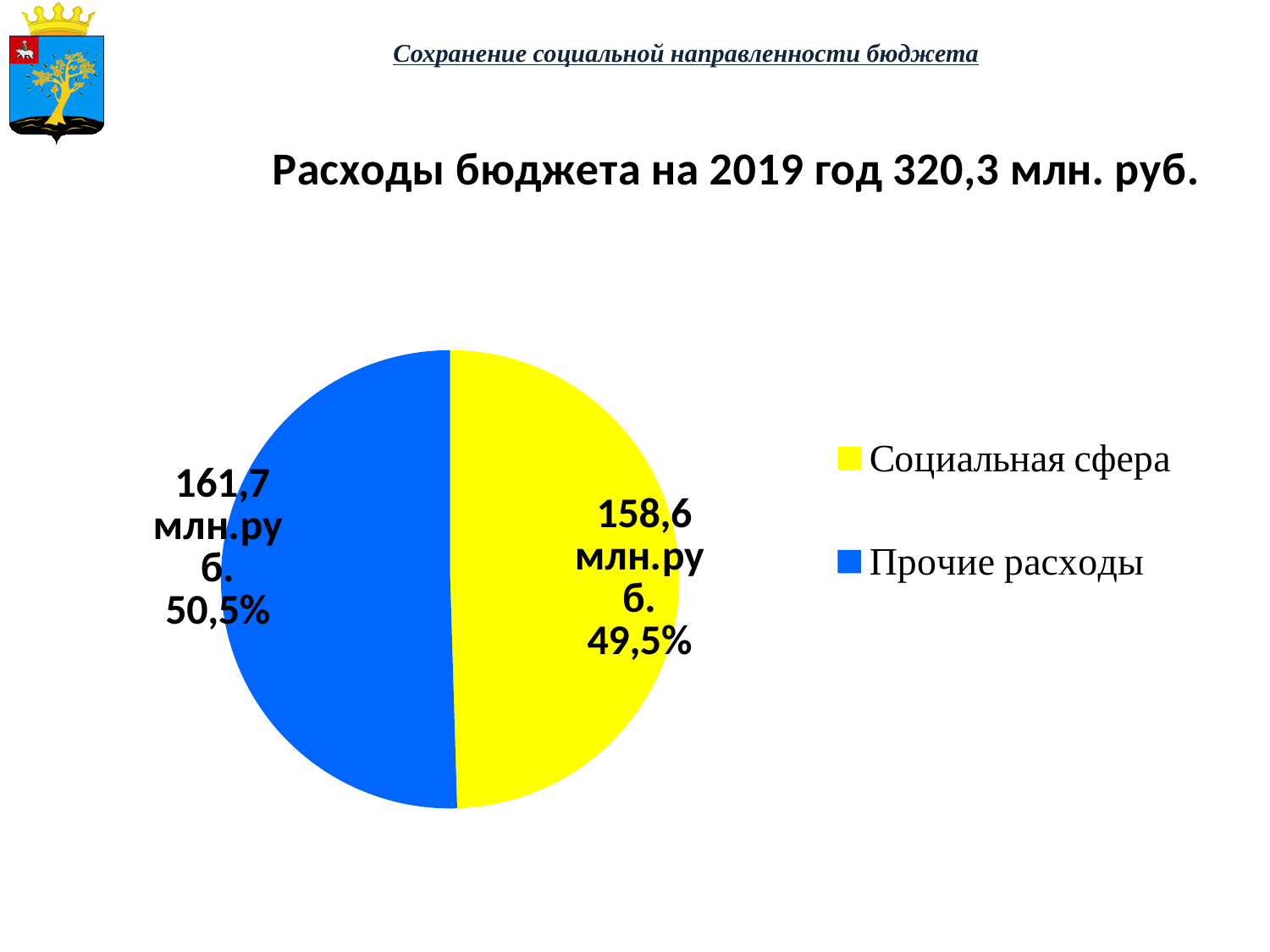
What kind of chart is shown on the slide? pie chart What is the value shown for Социальная сфера in the pie chart? 158,6 млн.руб. Which slice of the pie chart is larger, Социальная сфера or Прочие расходы? Прочие расходы What colour is the Социальная сфера slice in the pie chart? yellow What is the title of the chart on the slide? Расходы бюджета на 2019 год 320,3 млн. руб. What is the difference between the values for Прочие расходы and Социальная сфера? 3,1 млн.руб. What share of the pie does Прочие расходы represent? 50,5% How many entries does the legend of the pie chart list? 2 What is the value shown for Прочие расходы in the pie chart? 161,7 млн.руб. What share of the pie does Социальная сфера represent? 49,5% What is the total budget expenditure for 2019 stated in the chart title? 320,3 млн. руб. How many slices does the pie chart have? 2